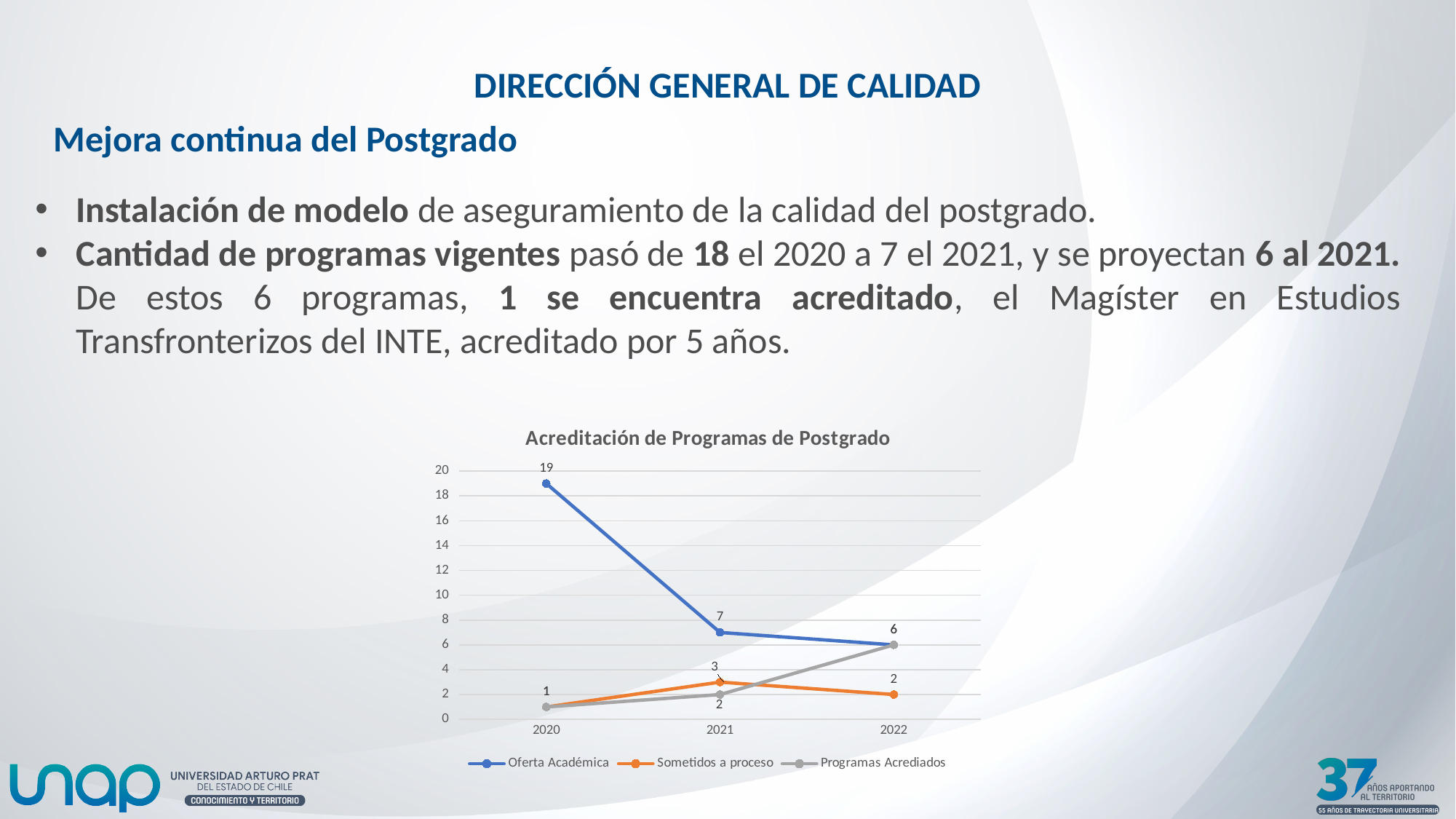
What is the value of Oferta Académica in 2020? 19 How many years are shown on the x axis of the chart? 3 Does Oferta Académica rise or fall from 2020 to 2022? fall In which year is Oferta Académica highest? 2020 Which is larger in 2021, Oferta Académica or Sometidos a proceso? Oferta Académica What type of chart is shown on the slide? line chart What is the title of the chart? Acreditación de Programas de Postgrado What is the value of Sometidos a proceso in 2021? 3 By how much did Oferta Académica decrease from 2020 to 2021? 12 How many series does the chart legend list? 3 What is the value of Oferta Académica in 2021? 7 What is the value of Sometidos a proceso in 2022? 2